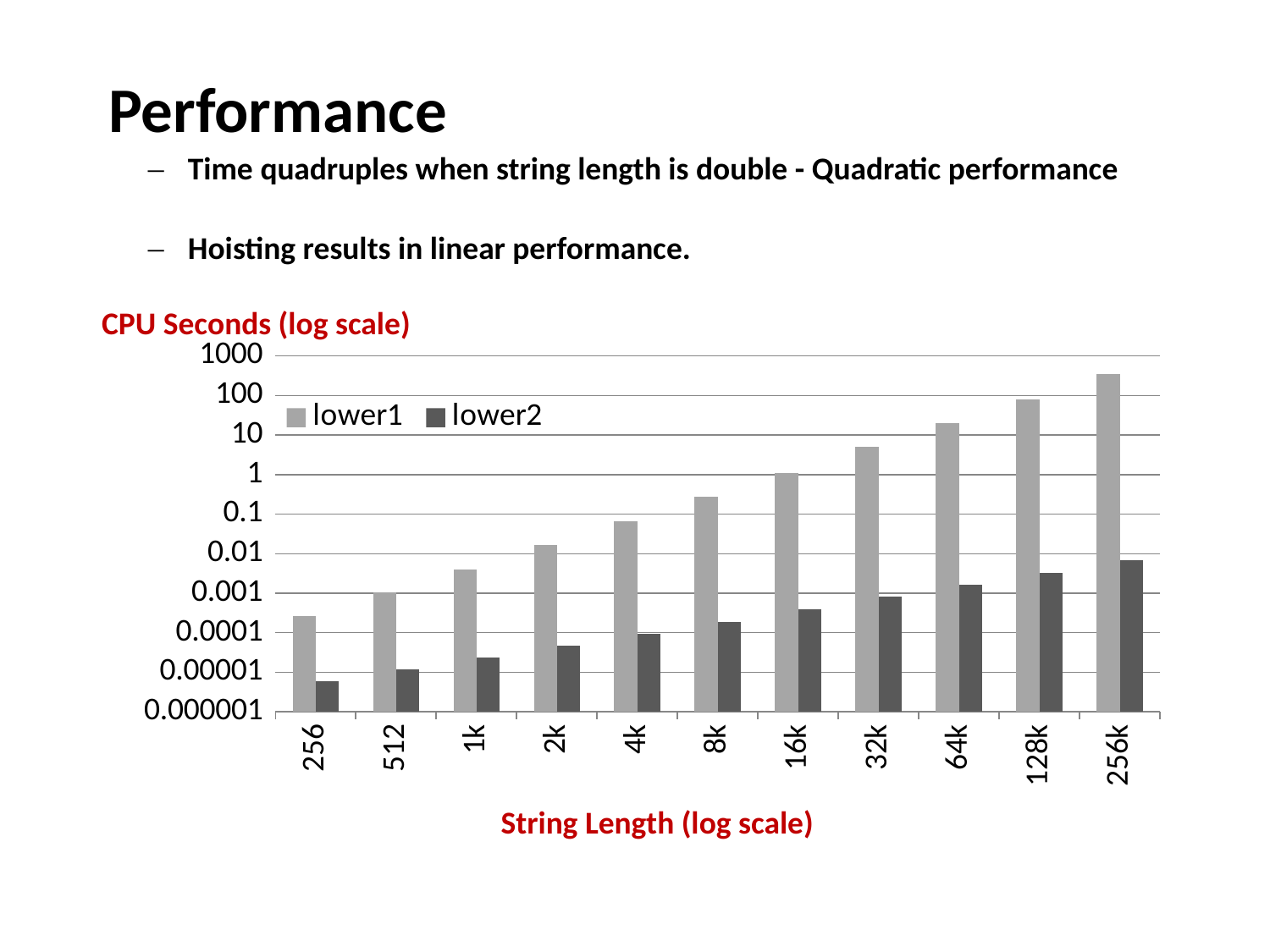
Is the lower1 value for 64k greater or less than 10? greater What is the label of the vertical axis of the chart? CPU Seconds (log scale) Is the lower1 value for 256k greater or less than 100? greater What kind of chart is shown on the slide? bar chart Do the lower2 values rise or fall as string length increases along the x axis? rise Which string length has the lowest lower2 value? 256 Which string length has the highest lower1 value? 256k Is the lower2 value for 256k greater or less than 0.01? less How many series does the chart legend list? 2 How many string-length categories are plotted along the x axis? 11 At string length 8k, which series has the larger value, lower1 or lower2? lower1